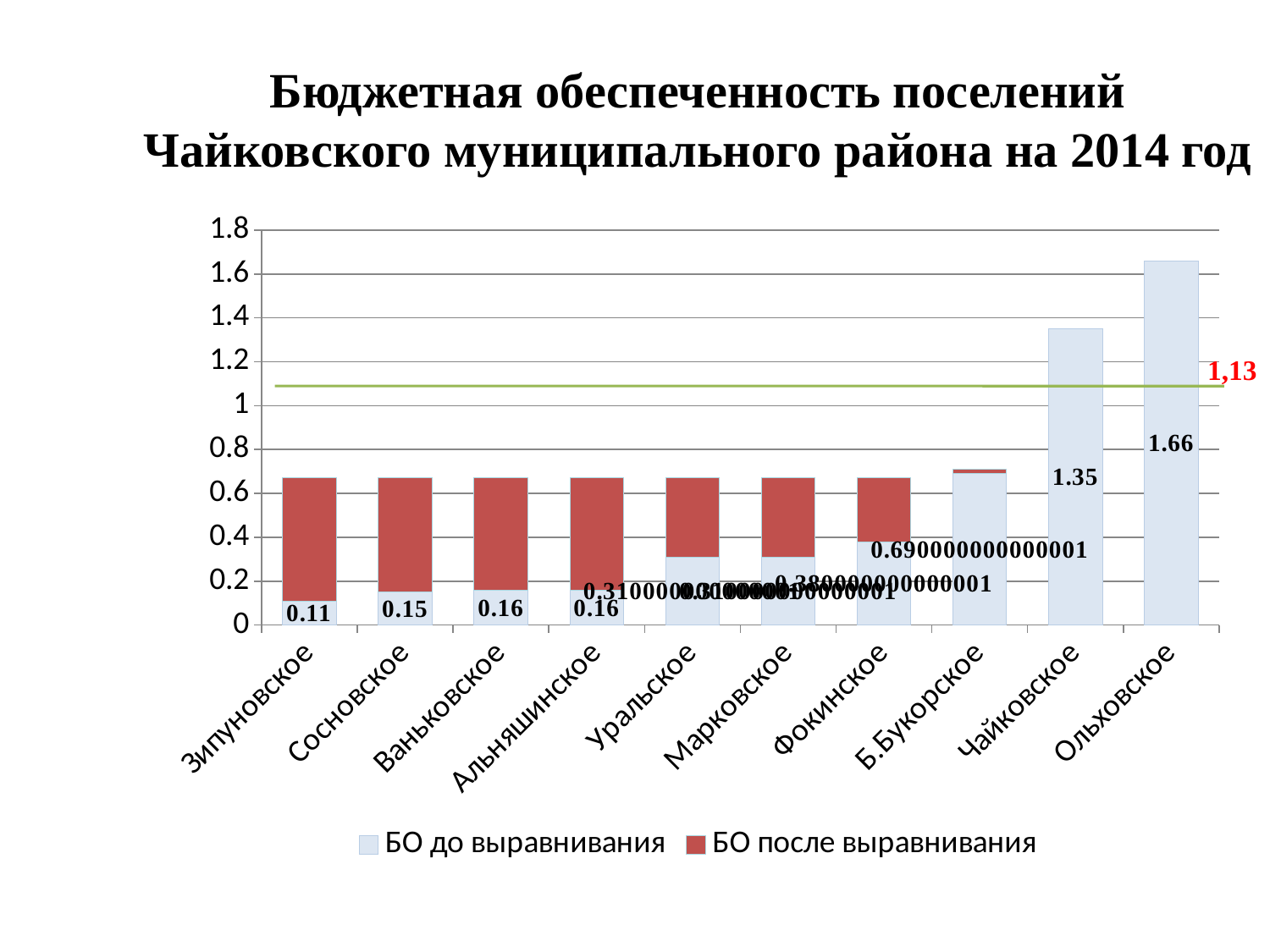
What is the value of "БО до выравнивания" for Сосновское? 0.15 What value is marked by the horizontal line across the chart? 1,13 How many settlements are shown on the x axis? 10 What is the value of "БО до выравнивания" for Зипуновское? 0.11 How many series does the legend list? 2 What is the difference between the "БО до выравнивания" values for Ольховское and Чайковское? 0.31 Which settlement has the lowest value of "БО до выравнивания"? Зипуновское What is the value of "БО до выравнивания" for Ольховское? 1.66 Which settlement has the highest value of "БО до выравнивания"? Ольховское What is the value of "БО до выравнивания" for Чайковское? 1.35 Which has a larger "БО до выравнивания" value, Чайковское or Ольховское? Ольховское